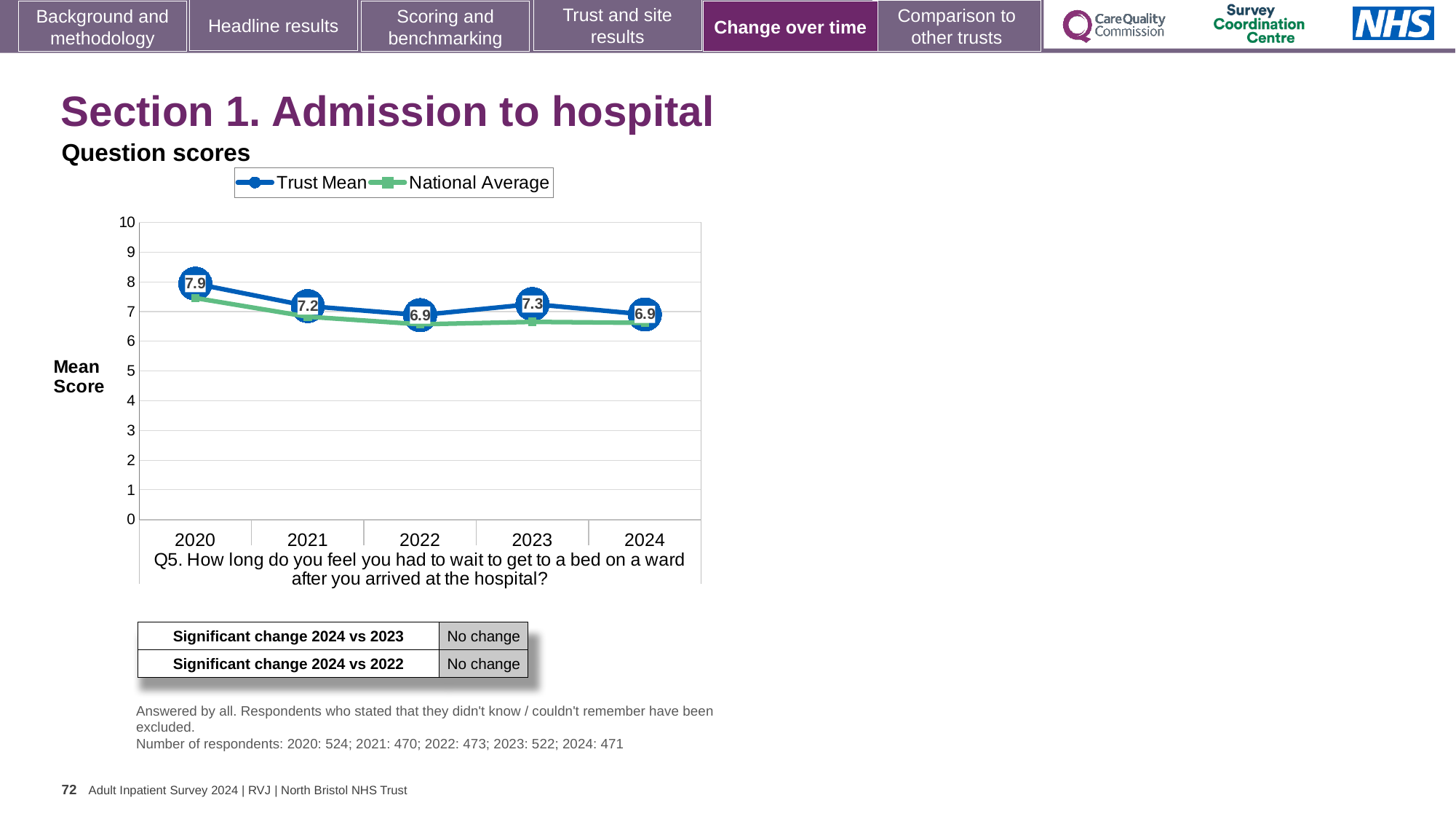
What is the label on the y axis of the chart? Mean Score In which year is the Trust Mean score highest? 2020 What is the Trust Mean score for 2020? 7.9 What is the Trust Mean score for 2024? 6.9 What is the Trust Mean score for 2023? 7.3 How many series does the legend list? 2 Is the National Average value for 2020 greater or less than 7? greater What kind of chart is shown on the slide? Line chart Does the Trust Mean score rise or fall from 2020 to 2022? Fall How many years are plotted on the x axis? 5 What is the difference between the Trust Mean scores for 2020 and 2021? 0.7 Which year has the larger Trust Mean score, 2021 or 2023? 2023